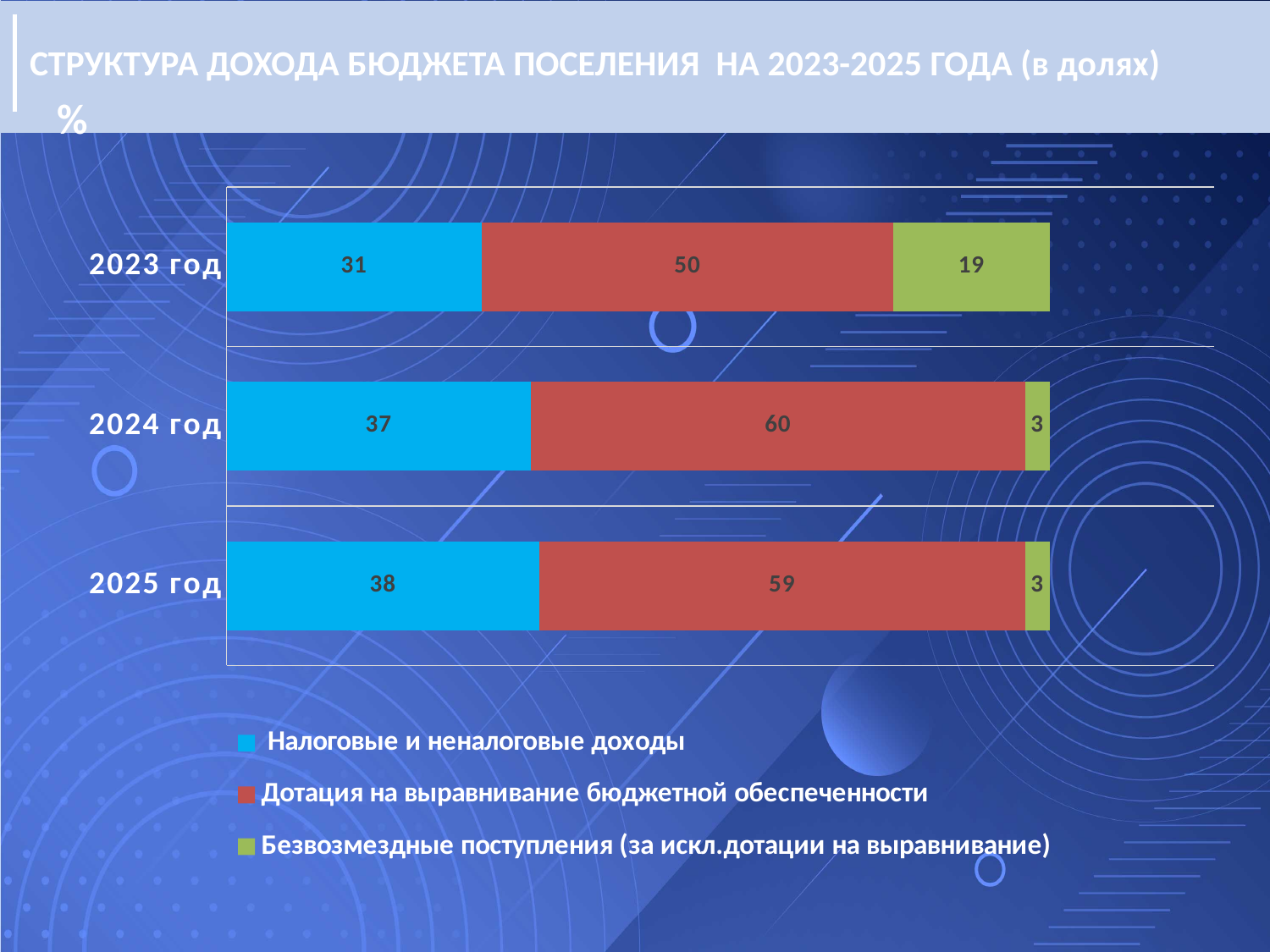
What is the value of Безвозмездные поступления (за искл.дотации на выравнивание) for 2023 год? 19 How many years (categories) are shown on the chart? 3 In which year is the value of Налоговые и неналоговые доходы the highest? 2025 год What is the total of the stacked bar for 2023 год? 100 What is the value of Безвозмездные поступления (за искл.дотации на выравнивание) for 2025 год? 3 What kind of chart is shown on the slide? Stacked bar chart In which year is the value of Дотация на выравнивание бюджетной обеспеченности the lowest? 2023 год What is the value of Налоговые и неналоговые доходы for 2023 год? 31 What is the value of Дотация на выравнивание бюджетной обеспеченности for 2024 год? 60 Which is larger: Налоговые и неналоговые доходы for 2024 год or for 2023 год? 2024 год How many series does the legend list? 3 What is the difference between the Дотация на выравнивание бюджетной обеспеченности values for 2024 год and 2023 год? 10